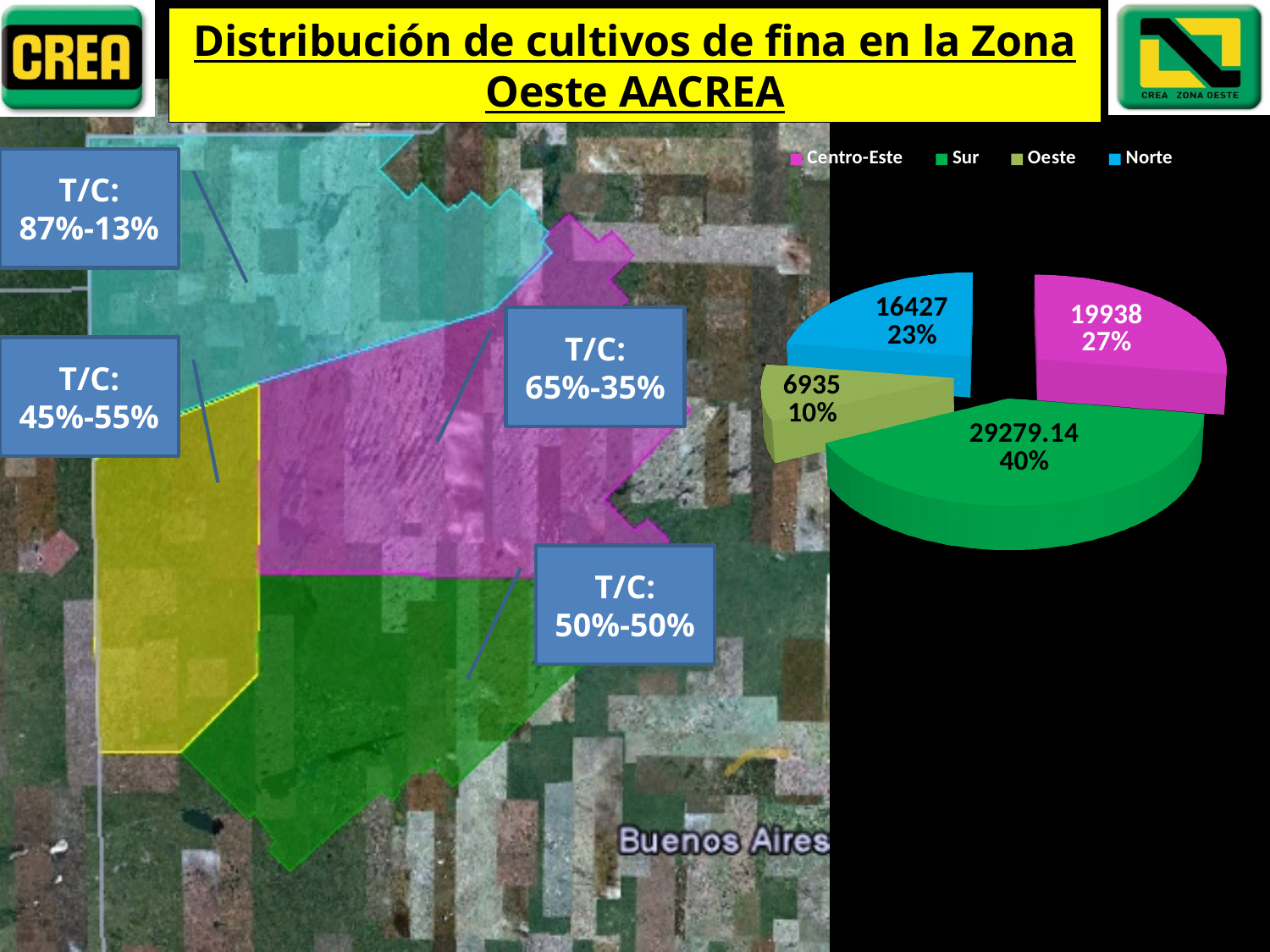
Which category has the largest slice in the pie chart? Sur Which category has the smallest slice in the pie chart? Oeste Which is larger in the pie chart, Centro-Este or Norte? Centro-Este What is the value shown for Sur in the pie chart? 29279.14 What is the value shown for Oeste in the pie chart? 6935 What type of chart is shown on the slide? pie chart What percentage share does Centro-Este have in the pie chart? 27% What is the value shown for Norte in the pie chart? 16427 How many entries does the legend of the pie chart list? 4 How many slices does the pie chart have? 4 What is the difference between the values for Centro-Este and Norte in the pie chart? 3511 What percentage share does Sur have in the pie chart? 40%